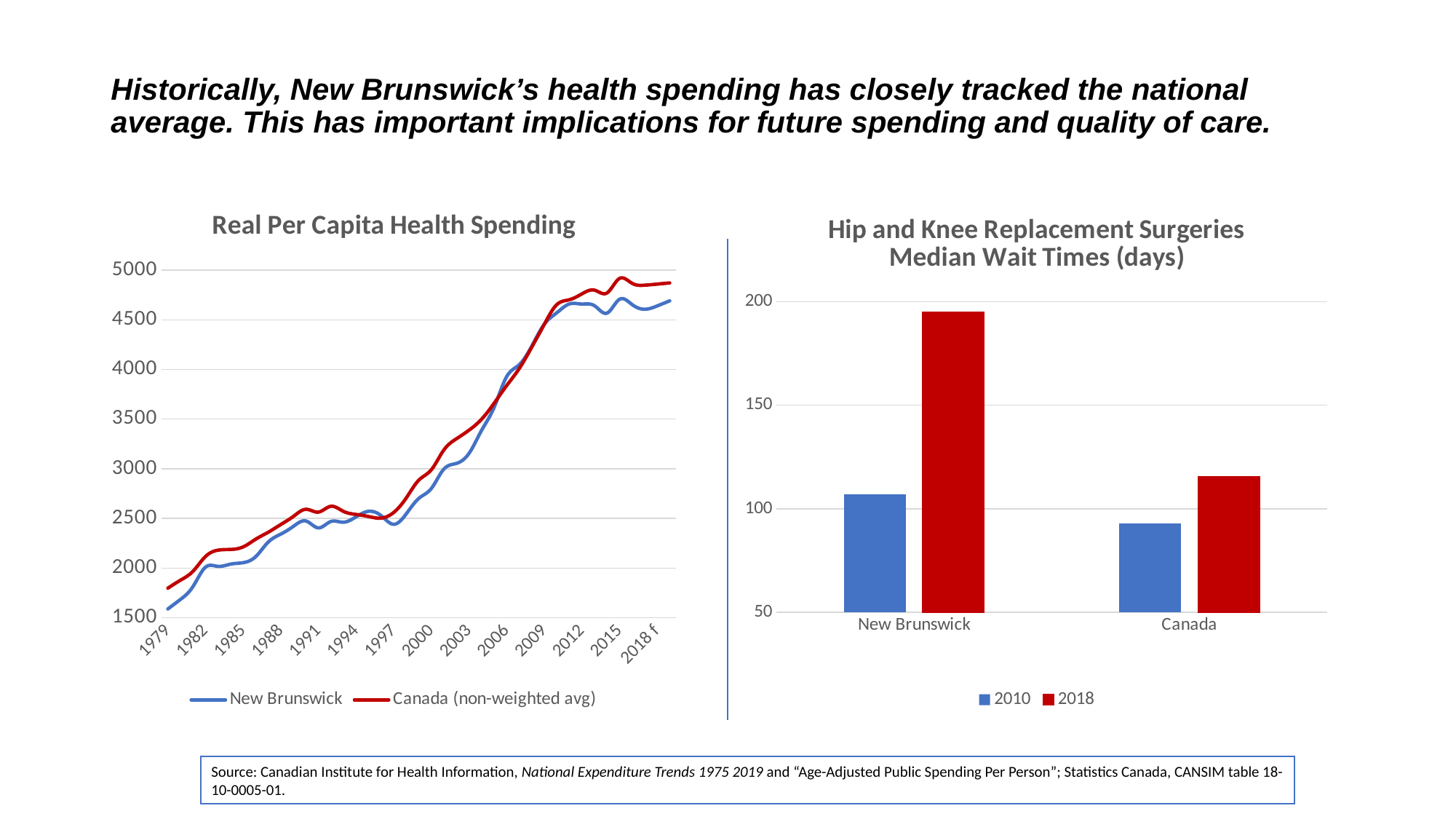
In the 'Hip and Knee Replacement Surgeries Median Wait Times (days)' chart, is the 2010 value for Canada greater or less than 100? less What kind of chart is the 'Hip and Knee Replacement Surgeries Median Wait Times (days)' chart? bar chart What kind of chart is the 'Real Per Capita Health Spending' chart? line chart In the 'Real Per Capita Health Spending' chart, do the values for New Brunswick generally rise or fall from 1979 to 2018 f? rise In the 'Hip and Knee Replacement Surgeries Median Wait Times (days)' chart, is the 2018 value for New Brunswick greater or less than 150? greater In the 'Hip and Knee Replacement Surgeries Median Wait Times (days)' chart, how many categories are shown on the x axis? 2 In the 'Hip and Knee Replacement Surgeries Median Wait Times (days)' chart, which bar is the highest? New Brunswick, 2018 In the 'Real Per Capita Health Spending' chart, is the value for Canada (non-weighted avg) in 2018 f greater or less than 4500? greater In the 'Real Per Capita Health Spending' chart, how many series does the legend list? 2 In the 'Hip and Knee Replacement Surgeries Median Wait Times (days)' chart, which is larger in 2018: New Brunswick or Canada? New Brunswick In the 'Hip and Knee Replacement Surgeries Median Wait Times (days)' chart, how many series does the legend list? 2